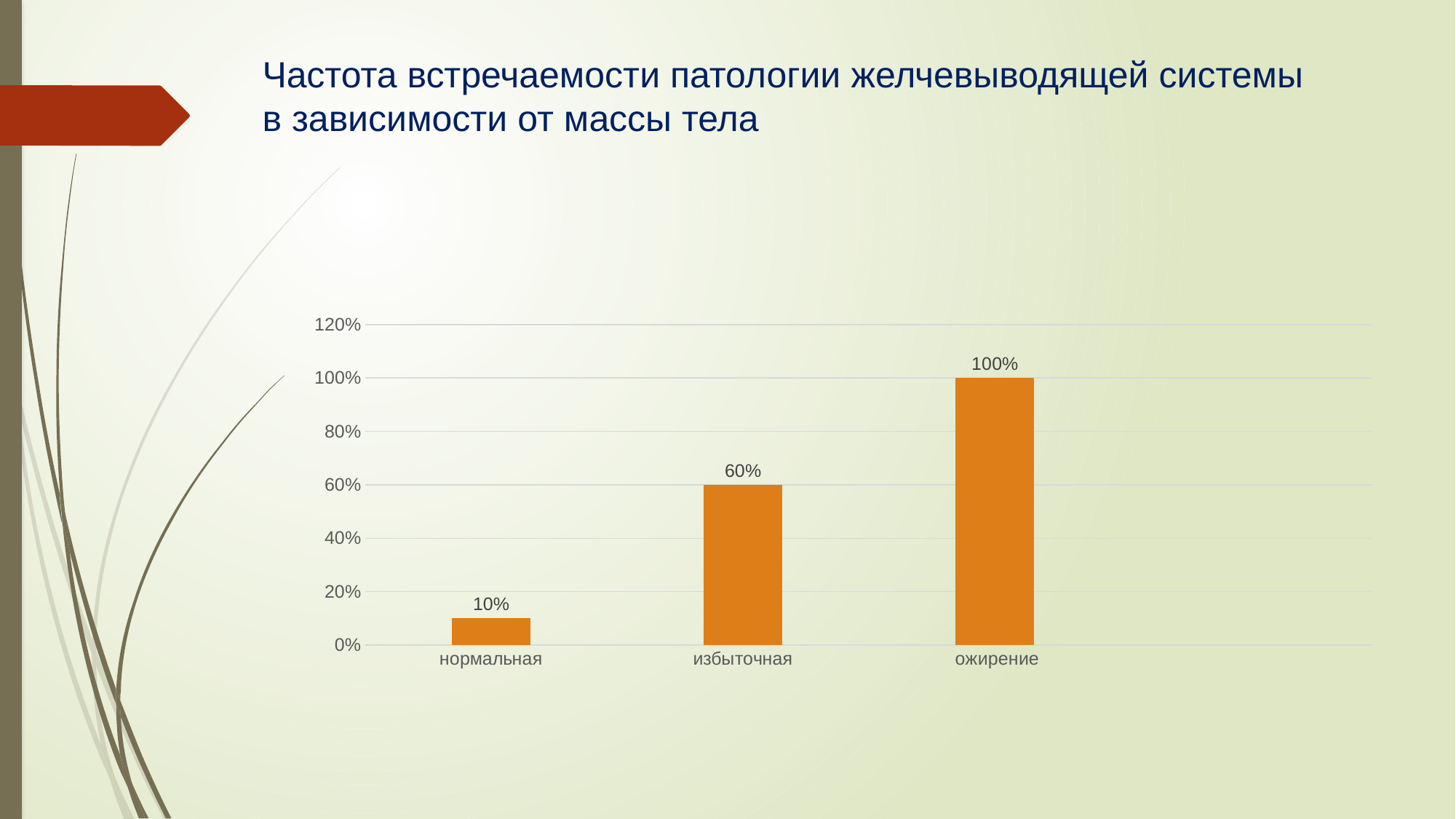
What is the value for нормальная? 10% Is the value for избыточная greater or less than 40%? greater What kind of chart is shown on the slide? bar chart Do the values rise or fall from left to right along the x axis? rise Which is larger, the value for избыточная or the value for нормальная? избыточная What is the value for ожирение? 100% Which category has the lowest value? нормальная What is the difference between the values for избыточная and нормальная? 50% How many categories are shown on the x axis? 3 What is the value for избыточная? 60% Which category has the highest value? ожирение What is the difference between the values for ожирение and избыточная? 40%